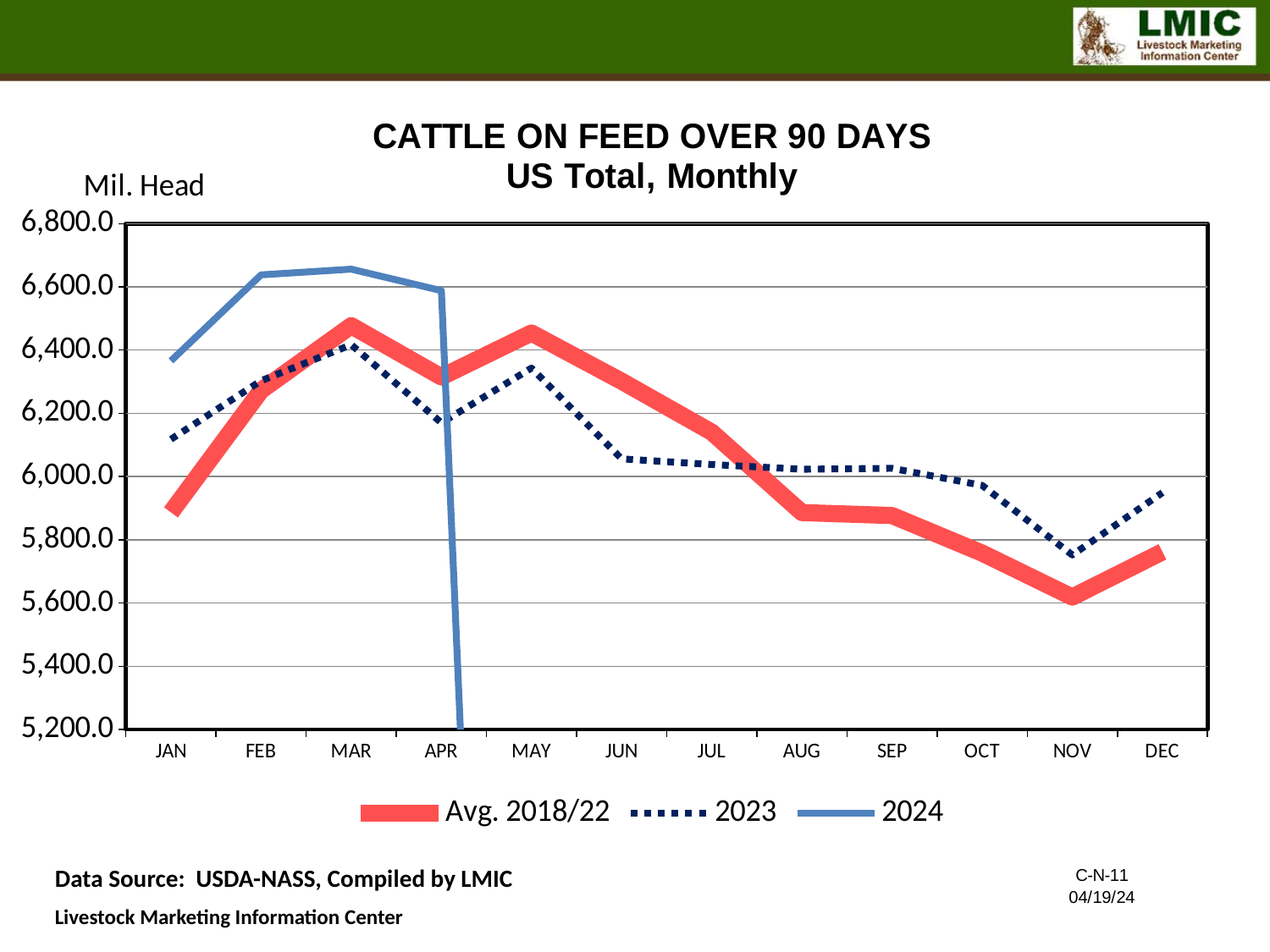
In which month is the 2023 series at its lowest? NOV Does the Avg. 2018/22 series rise or fall from MAY to NOV? fall In MAR, which series is higher: 2024 or 2023? 2024 How many months are shown along the x axis? 12 In NOV, which series is higher: Avg. 2018/22 or 2023? 2023 What kind of chart is shown on the slide? line chart Is the Avg. 2018/22 value for JAN greater or less than 6,000.0? less In which month is the Avg. 2018/22 series at its lowest? NOV How many series does the legend list? 3 Is the 2023 value for JUN greater or less than 6,200.0? less Is the 2024 value for JAN greater or less than 6,200.0? greater In which month does the 2023 series reach its highest value? MAR